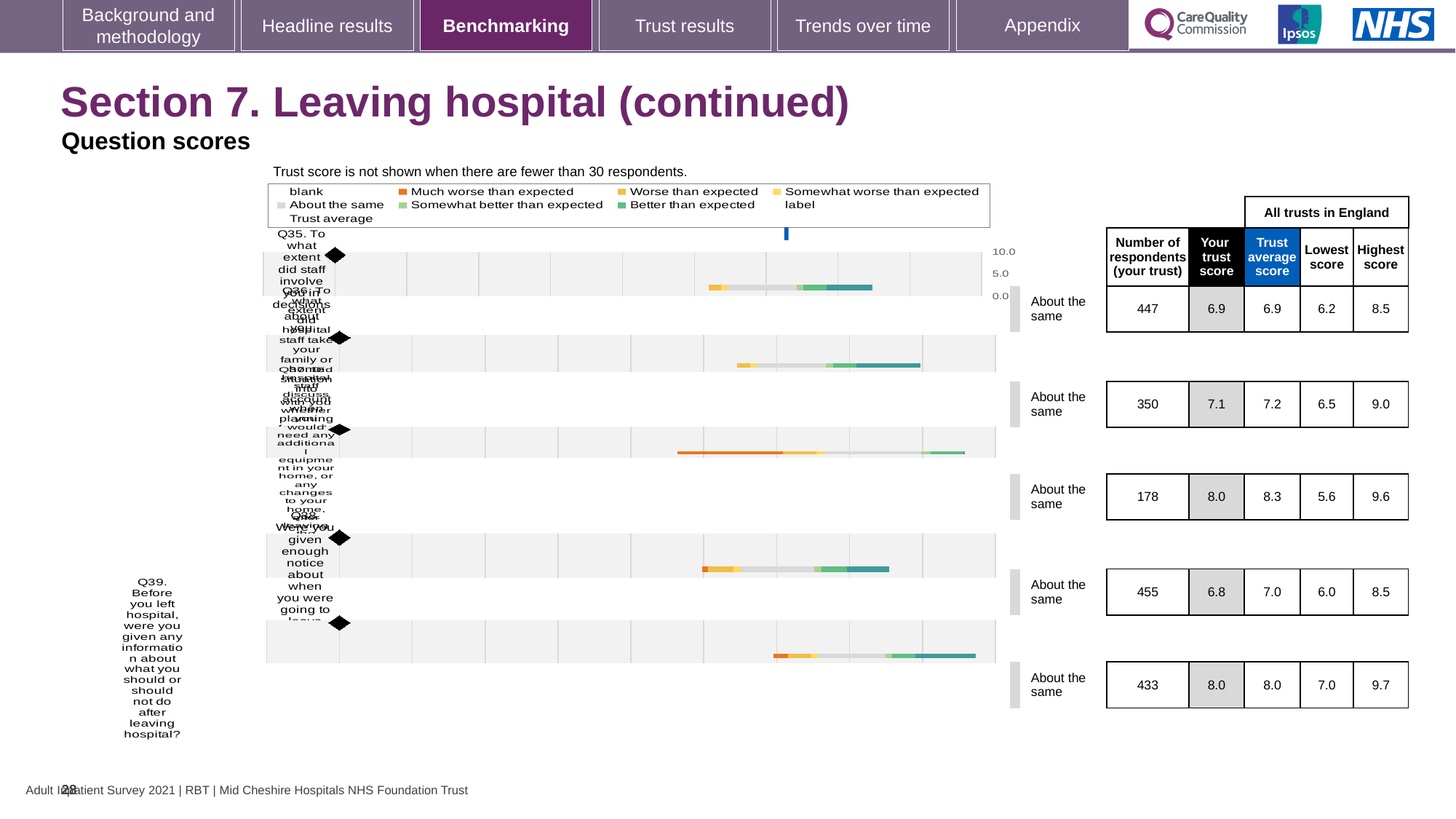
What is the lowest score for the question with 178 respondents? 5.6 Which question has the largest number of respondents? Q38 What kind of chart is used to show the question scores on this slide? bar chart What benchmark category is shown for every question on this slide? About the same For Q38, which is larger: your trust score or the trust average score? Trust average score What is the highest score across all trusts in England for Q39? 9.7 What is the number of respondents (your trust) for Q35? 447 What is the smallest number of respondents shown in the table? 178 What is your trust score for Q39 (information about what you should or should not do after leaving hospital)? 8.0 What is the trust average score for Q36? 7.2 For Q36, what is the difference between the highest score and the lowest score? 2.5 How many questions (Q35 to Q39) are plotted on the chart? 5